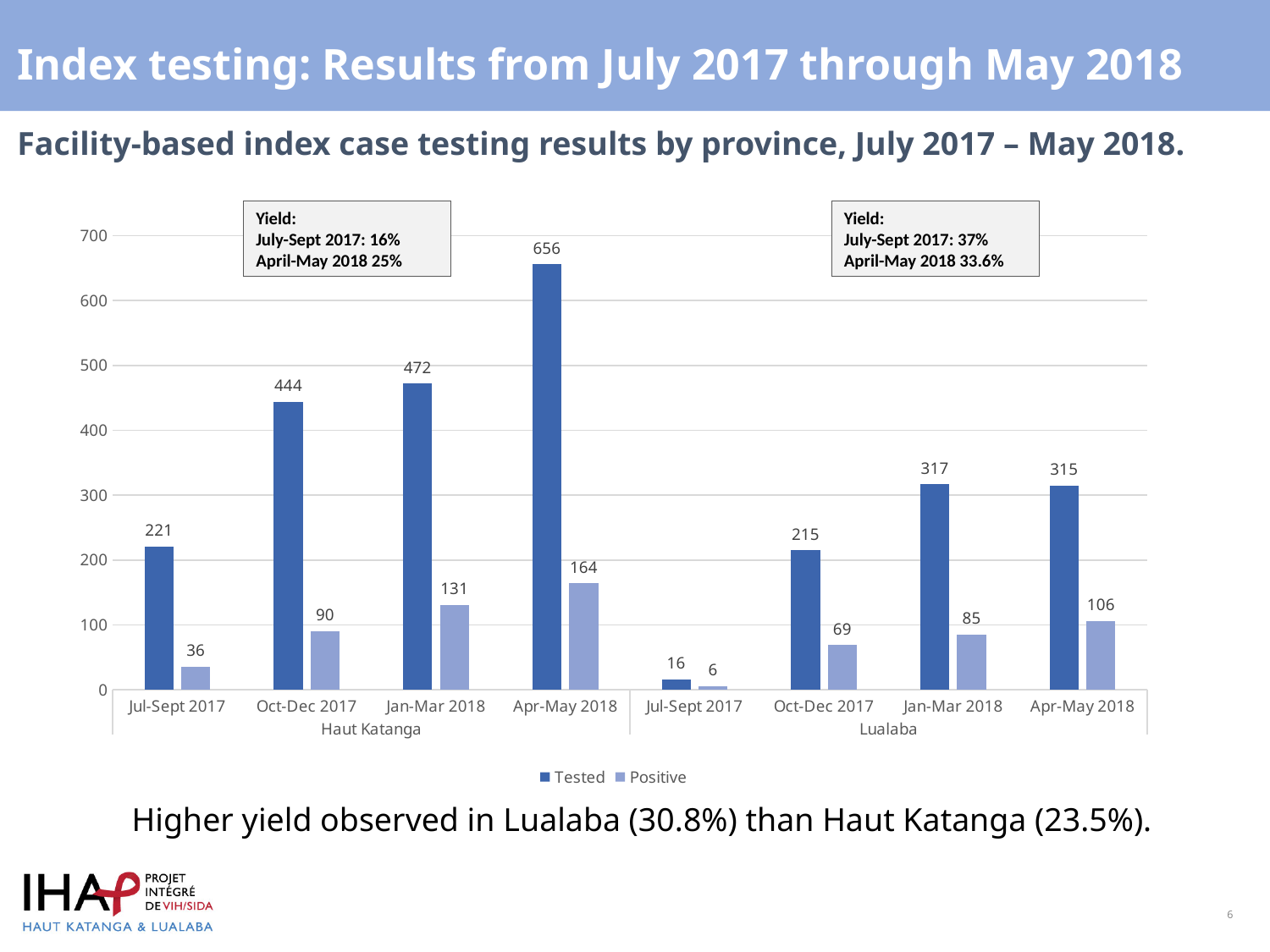
Is the number tested in Haut Katanga in Jan-Mar 2018 greater or less than 400? greater Which period and province has the highest number tested? Apr-May 2018, Haut Katanga What yield is reported for Lualaba in July-Sept 2017 in the text box? 37% Does the number tested in Lualaba rise or fall from Jul-Sept 2017 to Jan-Mar 2018? Rise Which is larger: the number tested in Lualaba in Jan-Mar 2018 or in Apr-May 2018? Jan-Mar 2018 Which period and province has the lowest number of positives? Jul-Sept 2017, Lualaba How many people were tested in Haut Katanga in Apr-May 2018? 656 What is the difference between the number tested in Haut Katanga in Oct-Dec 2017 and Jul-Sept 2017? 223 How many series does the legend list? 2 What kind of chart is shown on the slide? Bar chart How many positive results were recorded in Lualaba in Oct-Dec 2017? 69 How many time periods are shown for each province? 4